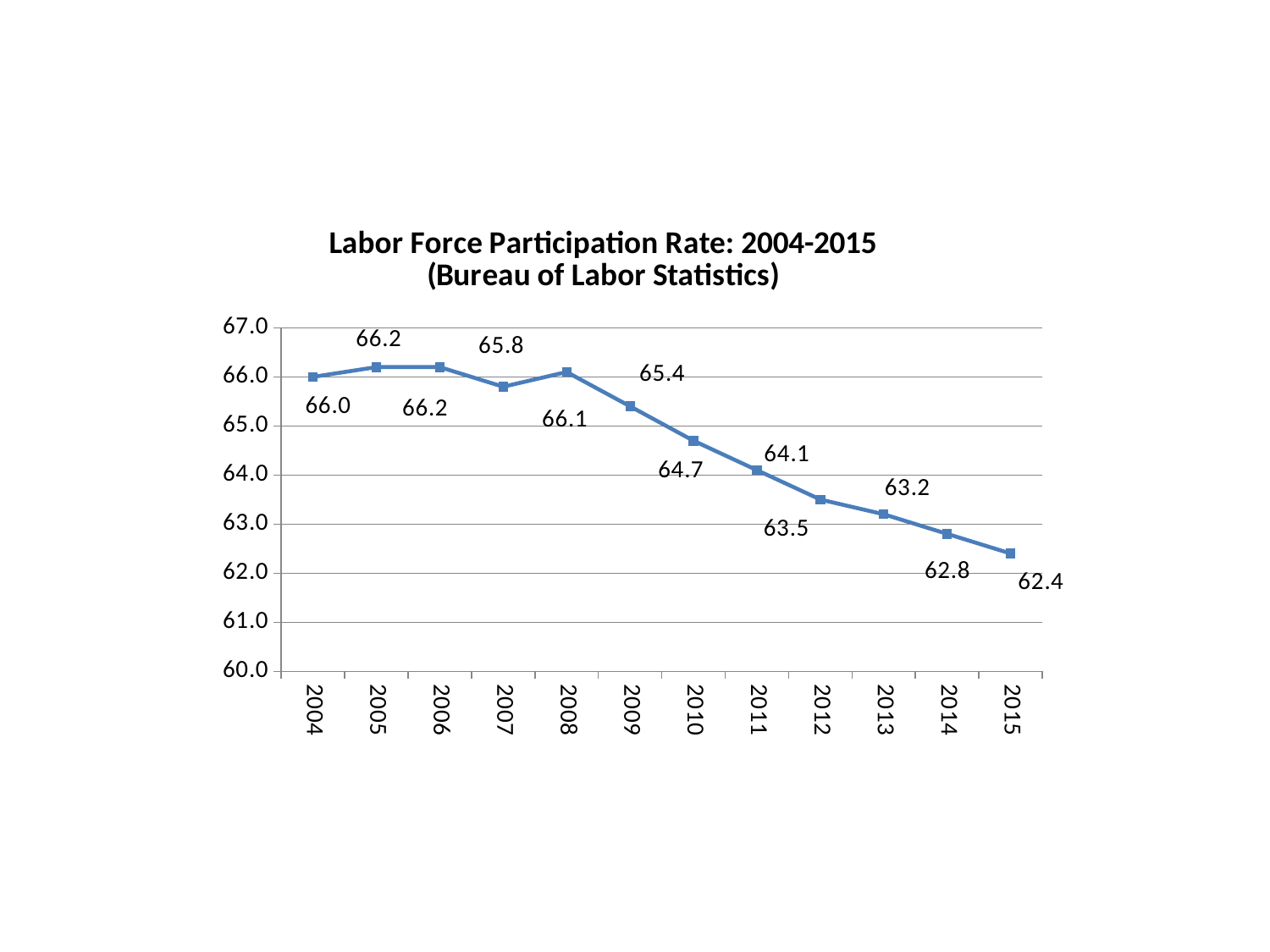
Which year has the lowest labor force participation rate? 2015 What is the difference between the labor force participation rate in 2004 and in 2015? 3.6 Does the labor force participation rate generally rise or fall from 2008 to 2015? Fall What is the difference between the labor force participation rate in 2008 and in 2009? 0.7 Is the labor force participation rate for 2011 greater or less than 64.0? greater What is the labor force participation rate for 2015? 62.4 What is the labor force participation rate for 2009? 65.4 How many years are plotted on the chart? 12 What is the labor force participation rate for 2004? 66.0 What is the labor force participation rate for 2012? 63.5 Which year has a higher labor force participation rate, 2010 or 2013? 2010 What kind of chart is shown on the slide? Line chart